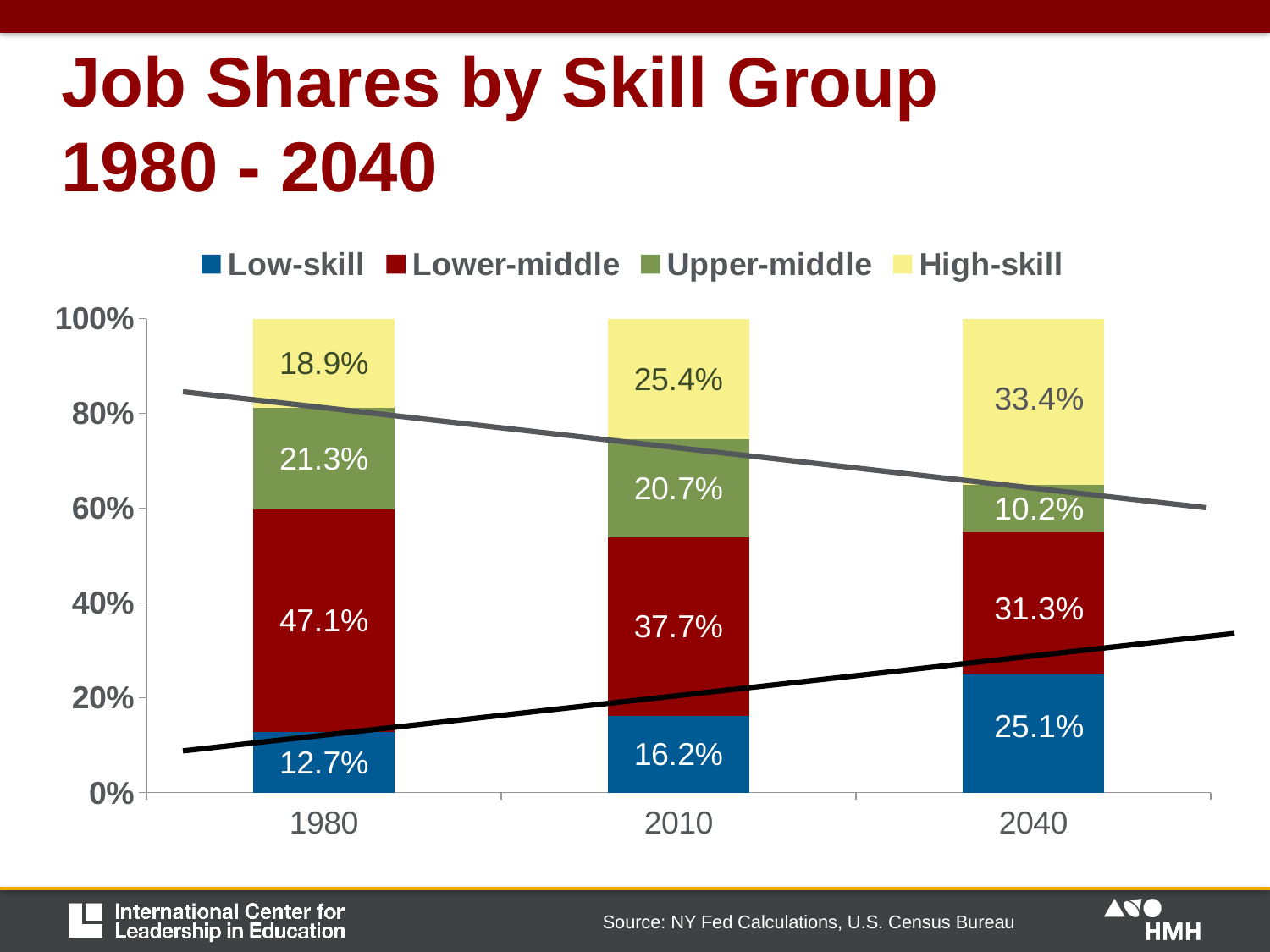
What is the Upper-middle job share in 2040? 10.2% What is the Lower-middle job share in 2010? 37.7% Which is larger in 2010: the High-skill share or the Upper-middle share? High-skill Which skill group has the smallest job share in 2040? Upper-middle What is the Low-skill job share in 1980? 12.7% Which skill group has the largest job share in 1980? Lower-middle What kind of chart is shown on the slide? Stacked bar chart Does the Low-skill job share rise or fall from 1980 to 2040? Rise How many years are shown on the x axis? 3 By how many percentage points does the Lower-middle share fall from 1980 to 2040? 15.8 percentage points What is the High-skill job share in 2040? 33.4% How many skill groups does the legend list? 4